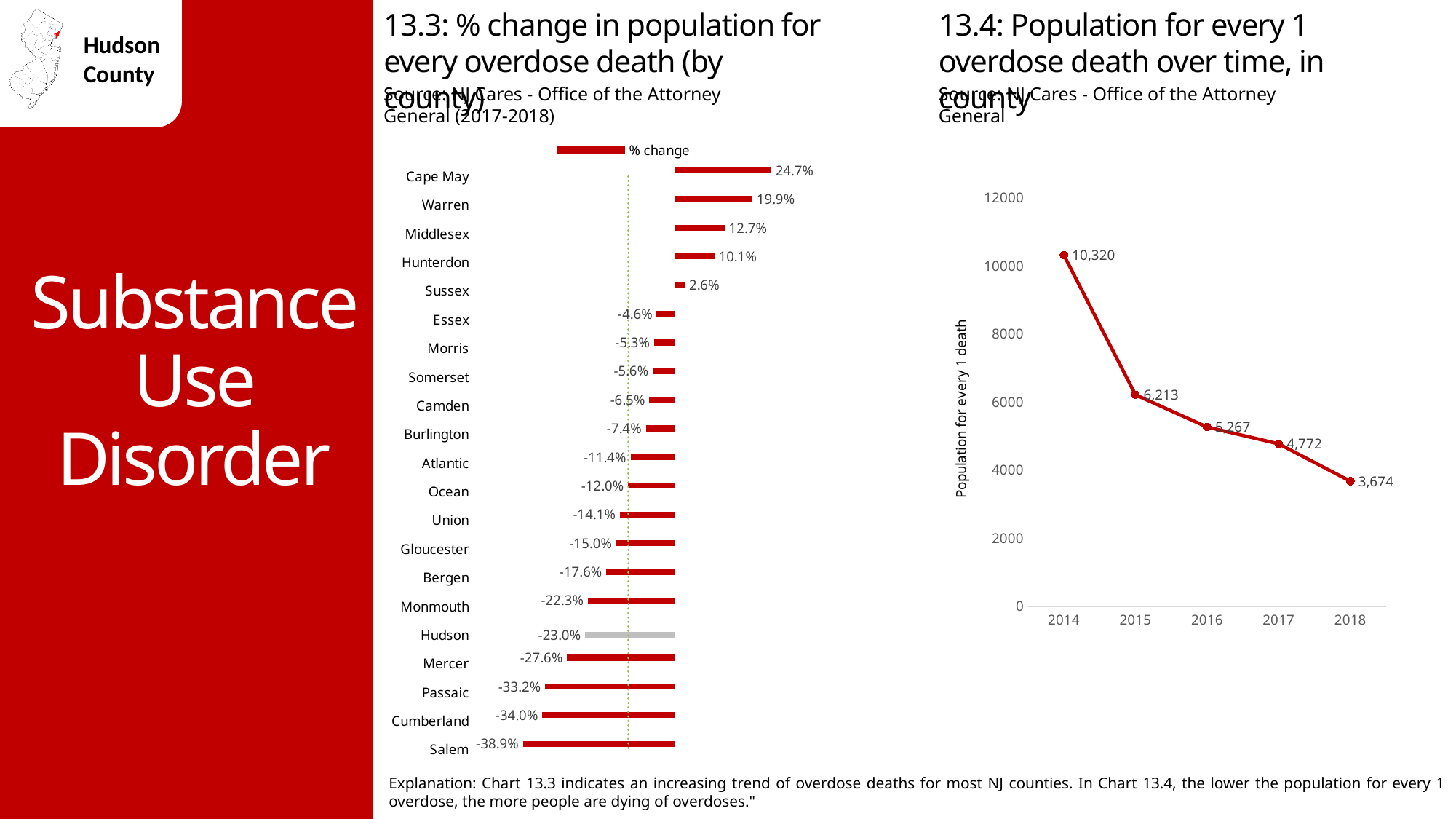
In chart 13.3, what is the % change for Hudson? -23.0% In chart 13.4, what is the difference between the 2015 and 2016 values? 946 In chart 13.3, which county has the lowest % change? Salem In chart 13.3, which has a larger % change, Mercer or Passaic? Mercer In chart 13.3, which county has the highest % change? Cape May In chart 13.4, what is the population for every 1 overdose death in 2018? 3,674 In chart 13.3, what is the % change for Cape May? 24.7% What kind of chart is chart 13.3? Bar chart In chart 13.3, what is the difference between the % change for Warren and Middlesex? 7.2 percentage points In chart 13.3, how many counties are shown? 21 In chart 13.4, do the values rise or fall from 2014 to 2018? Fall In chart 13.4, what is the population for every 1 overdose death in 2014? 10,320